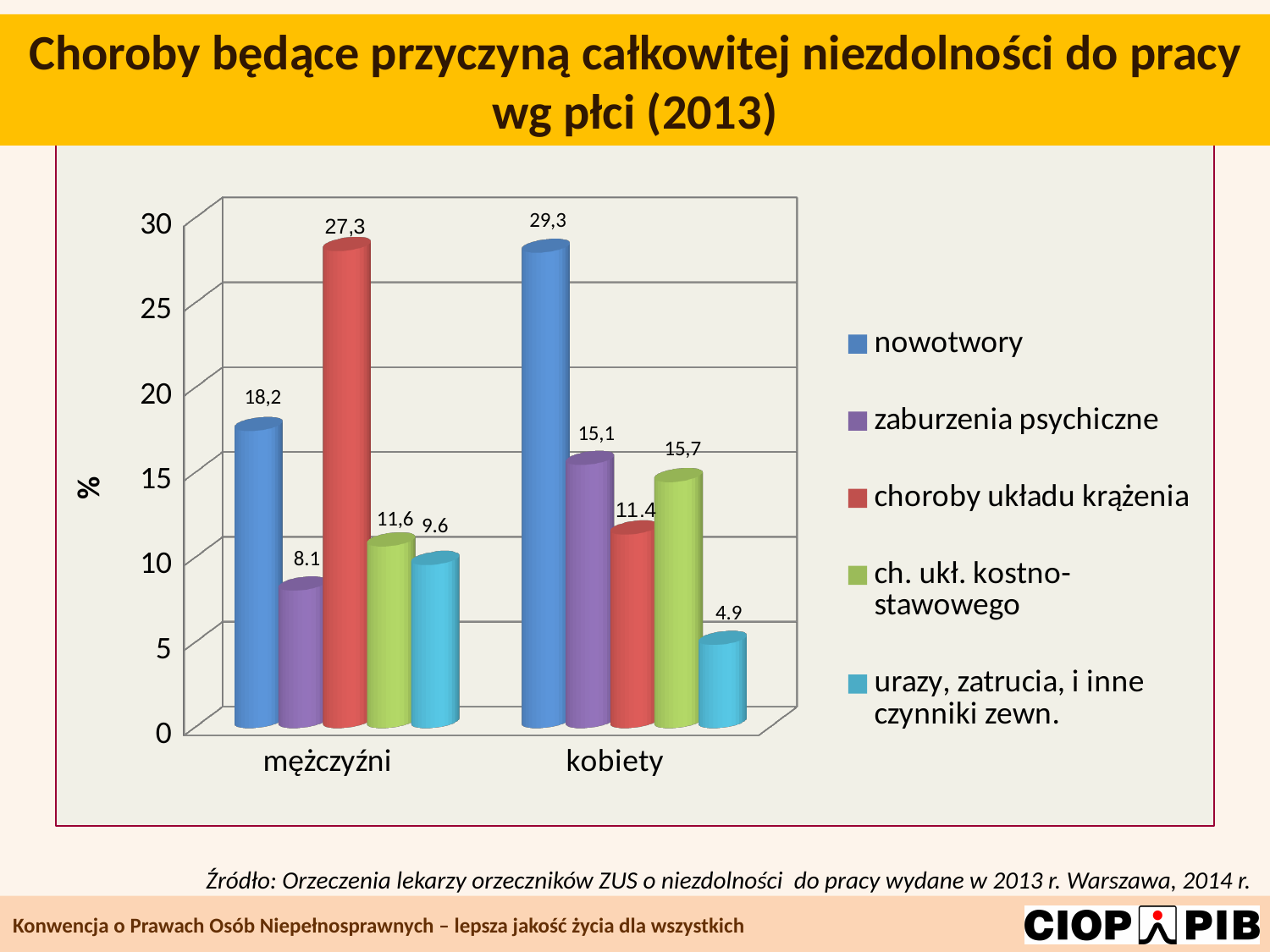
What is the value for nowotwory among kobiety? 29,3 What is the value for choroby układu krążenia among mężczyźni? 27,3 Which disease group has the highest value among mężczyźni? choroby układu krążenia How many categories are shown on the x axis? 2 What is the difference between the nowotwory values for kobiety and mężczyźni? 11,1 What is the difference between the ch. ukł. kostno-stawowego values for kobiety and mężczyźni? 4,1 What is the value for zaburzenia psychiczne among mężczyźni? 8.1 Which is larger: zaburzenia psychiczne for kobiety or choroby układu krążenia for kobiety? zaburzenia psychiczne for kobiety How many series does the legend list? 5 What kind of chart is shown on the slide? bar chart Which disease group has the lowest value among kobiety? urazy, zatrucia, i inne czynniki zewn. What is the value for urazy, zatrucia, i inne czynniki zewn. among kobiety? 4.9